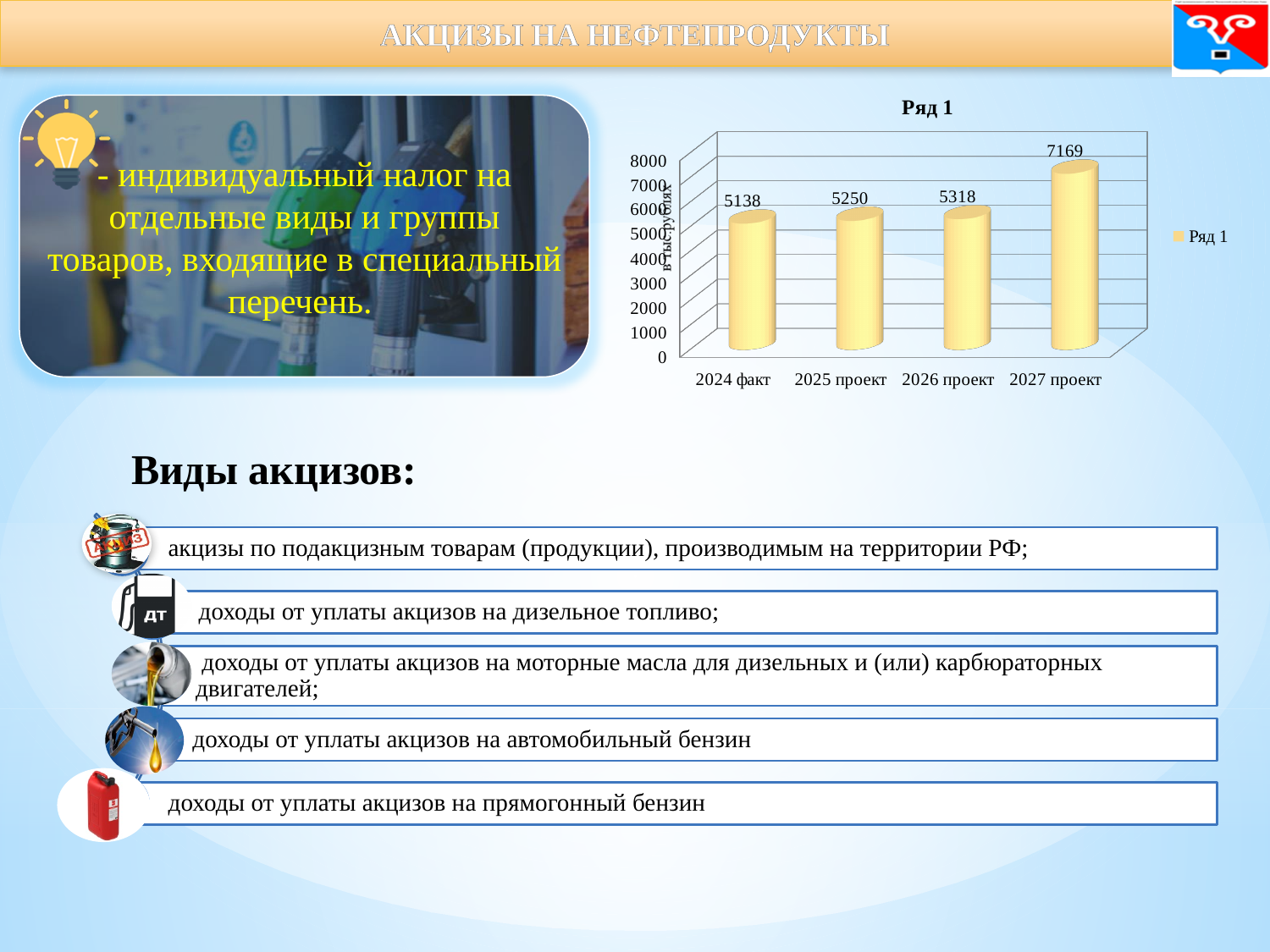
Which is larger, the value for 2027 проект or the value for 2024 факт? 2027 проект What is the difference between the values for 2027 проект and 2026 проект? 1851 Which category has the lowest value? 2024 факт What kind of chart is shown on the slide? bar chart Which category has the highest value? 2027 проект How many categories are shown on the x axis of the chart? 4 What is the value for 2027 проект? 7169 What is the value for 2025 проект? 5250 What is the value for 2024 факт? 5138 What is the value for 2026 проект? 5318 Do the values rise or fall from 2024 факт to 2027 проект? rise What is the difference between the values for 2025 проект and 2024 факт? 112